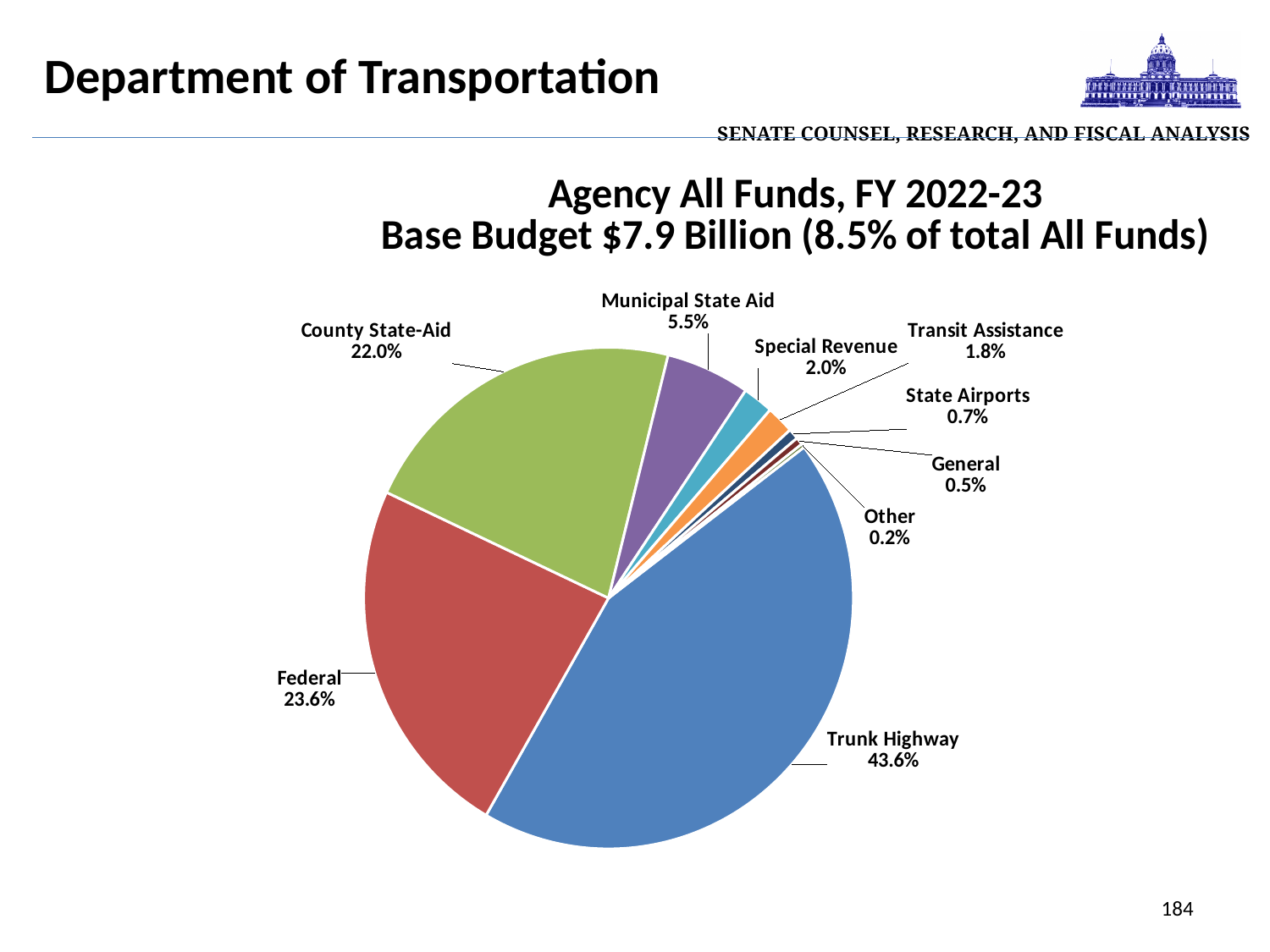
How many categories are shown in the pie chart? 9 Which category has the largest slice of the pie? Trunk Highway What is the value shown for Municipal State Aid? 5.5% What is the value shown for County State-Aid? 22.0% What is the value shown for State Airports? 0.7% What is the title of the chart? Agency All Funds, FY 2022-23 Base Budget $7.9 Billion (8.5% of total All Funds) What is the value shown for Federal? 23.6% What is the difference between the Federal and County State-Aid shares? 1.6% What kind of chart is shown on the slide? Pie chart Which is larger, Special Revenue or Transit Assistance? Special Revenue Which category has the smallest slice of the pie? Other What share of the pie does Trunk Highway represent? 43.6%